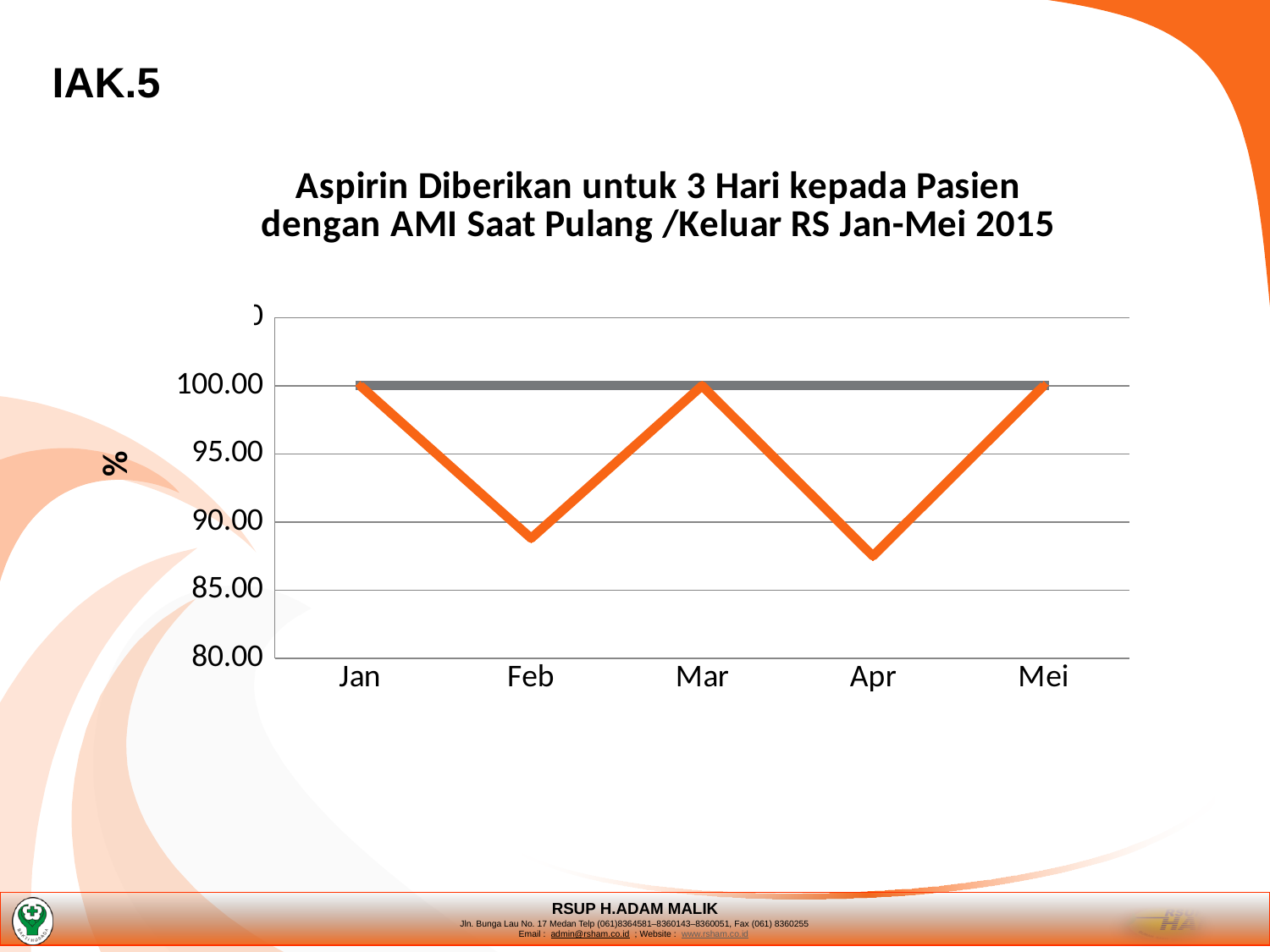
How many months are plotted along the x axis? 5 What is the title of the chart? Aspirin Diberikan untuk 3 Hari kepada Pasien dengan AMI Saat Pulang /Keluar RS Jan-Mei 2015 What is the label on the y axis? % What is the value of the orange line for Mei? 100.00 What is the value of the orange line for Mar? 100.00 Is the value of the orange line for Feb greater or less than 90.00? less Is the value of the orange line for Apr greater or less than 85.00? greater What is the value of the orange line for Jan? 100.00 Does the orange line rise or fall from Jan to Feb? fall Is the value of the orange line for Apr greater or less than 90.00? less What kind of chart is shown on the slide? line chart Which month has a larger value on the orange line, Feb or Apr? Feb